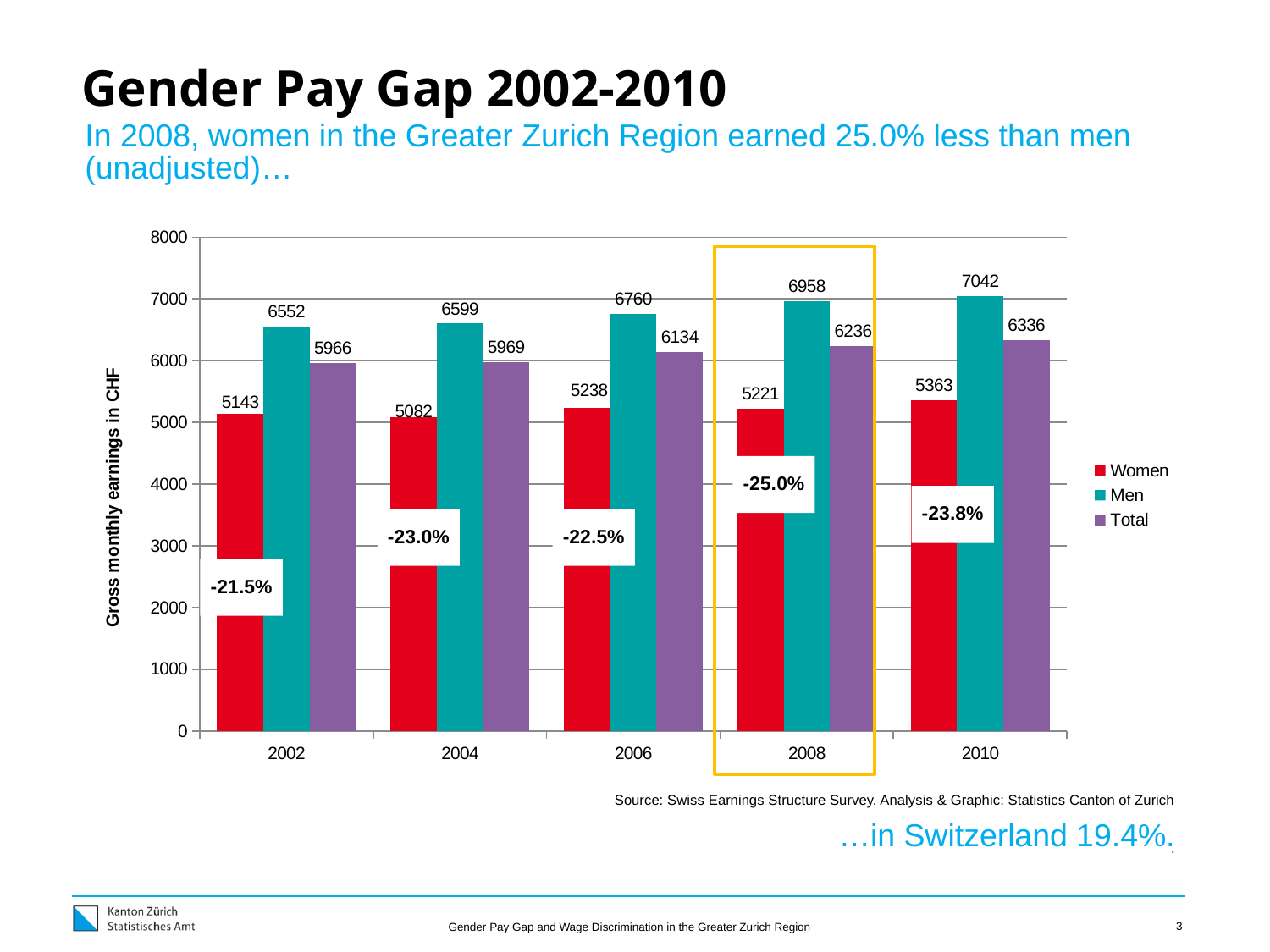
How many series does the legend list? 3 What were the gross monthly earnings for Men in 2008? 6958 What kind of chart is shown on the slide? bar chart In which year were Men's earnings the lowest? 2002 What is the Total value shown for 2010? 6336 Is the value for Women in 2002 greater or less than 6000? less What were the gross monthly earnings for Women in 2004? 5082 What is the difference between Men's and Women's earnings in 2008? 1737 What is the gender pay gap percentage labelled for 2004? -23.0% How many years are shown on the x axis? 5 In which year were Women's earnings the highest? 2010 Which is larger, the Total value for 2006 or the Total value for 2004? 2006